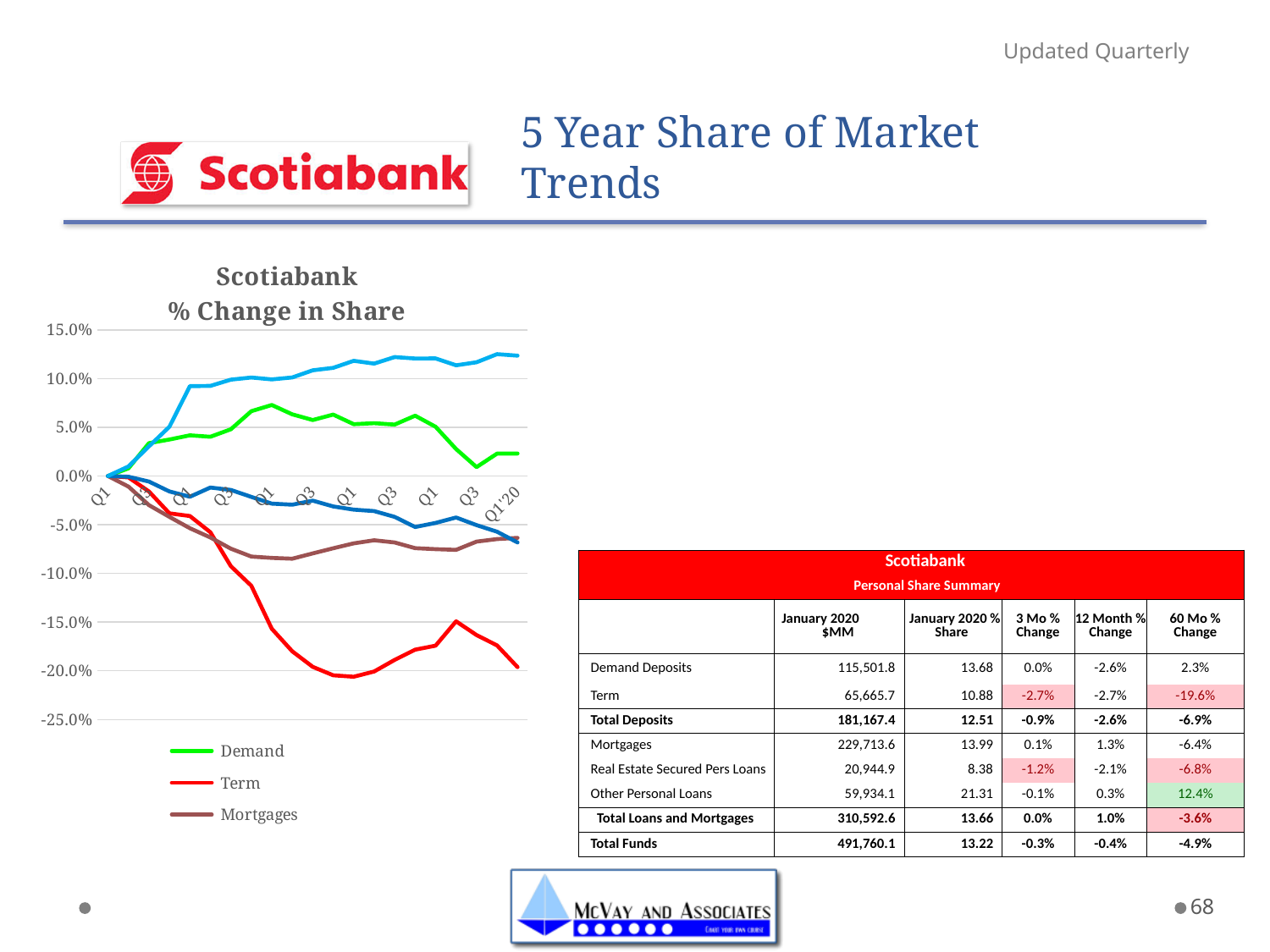
In the "Scotiabank % Change in Share" chart, which of the legend series (Demand, Term, Mortgages) reaches the highest value? Demand In the "Scotiabank % Change in Share" chart, does the Mortgages line overall rise or fall from Q1 to Q1'20? fall In the "Scotiabank % Change in Share" chart, is the Demand value at Q1'20 greater or less than 0.0%? greater What is the title of the chart on the left of the slide? Scotiabank % Change in Share In the "Scotiabank % Change in Share" chart, is the Term value at Q1'20 greater or less than -15.0%? less In the "Scotiabank % Change in Share" chart, does the Term line overall rise or fall from Q1 to Q1'20? fall In the "Scotiabank % Change in Share" chart, which is higher at Q1'20, Demand or Term? Demand How many series does the legend of the "Scotiabank % Change in Share" chart list? 3 In the "Scotiabank % Change in Share" chart, is the Mortgages value at Q1'20 greater or less than -5.0%? less In the "Scotiabank % Change in Share" chart, what colour is the Term line? red In the "Scotiabank % Change in Share" chart, which of the legend series (Demand, Term, Mortgages) reaches the lowest value? Term What kind of chart is the "Scotiabank % Change in Share" chart? line chart